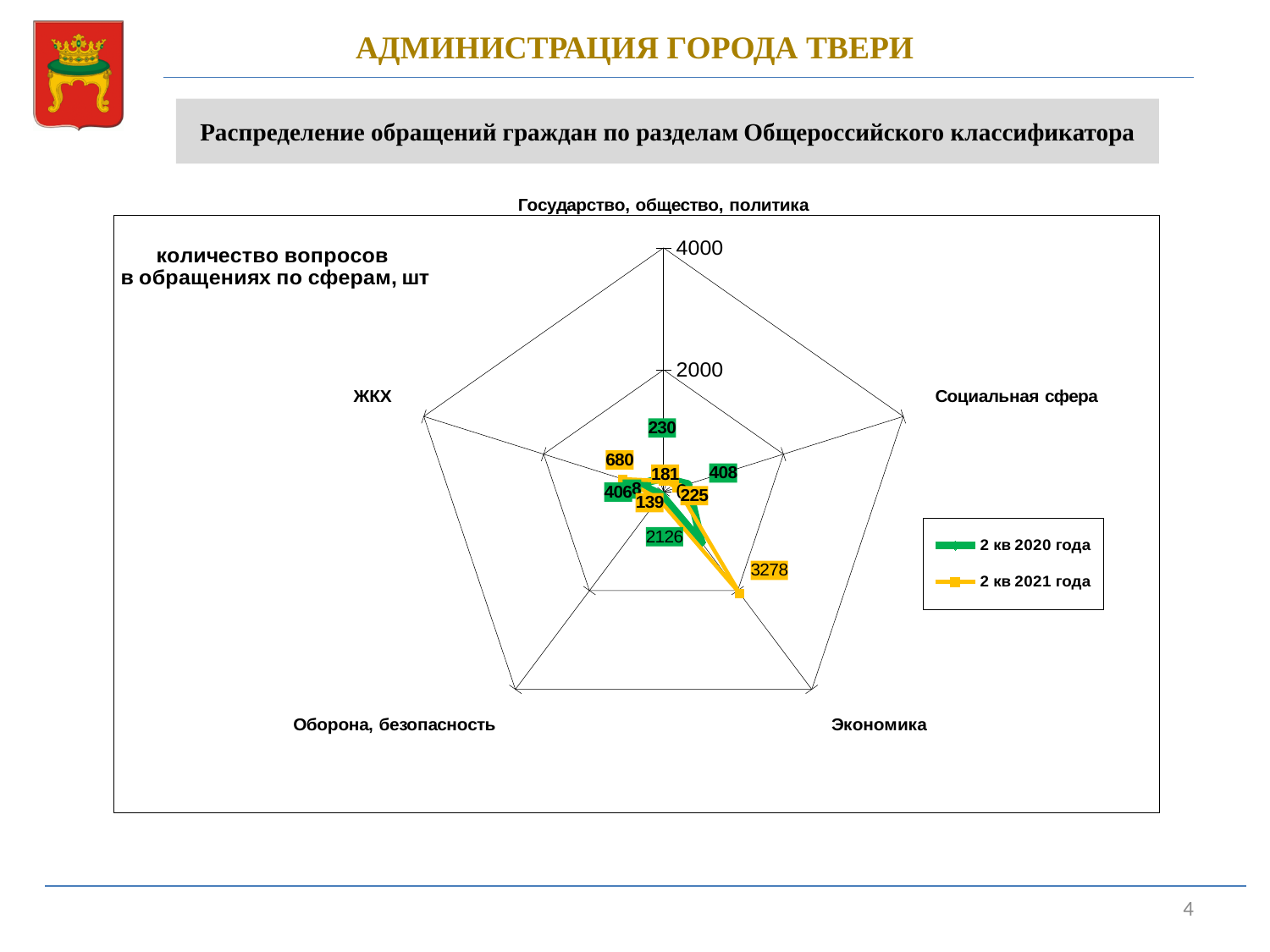
How many categories (axes) does the radar chart have? 5 What kind of chart is shown on the slide? Radar chart What is the value for Государство, общество, политика in the 2 кв 2020 года series? 230 What is the difference between the 2 кв 2021 года and 2 кв 2020 года values for Экономика? 1152 What is the maximum value shown on the radar chart's axis scale? 4000 Which category has the highest value in the 2 кв 2021 года series? Экономика What is the value for Экономика in the 2 кв 2020 года series? 2126 Is the value for Экономика in the 2 кв 2021 года series greater or less than 2000? greater How many series does the legend list? 2 What is the value for Экономика in the 2 кв 2021 года series? 3278 For Экономика, which series has the larger value: 2 кв 2020 года or 2 кв 2021 года? 2 кв 2021 года Is the value for Государство, общество, политика in the 2 кв 2020 года series greater or less than 2000? less